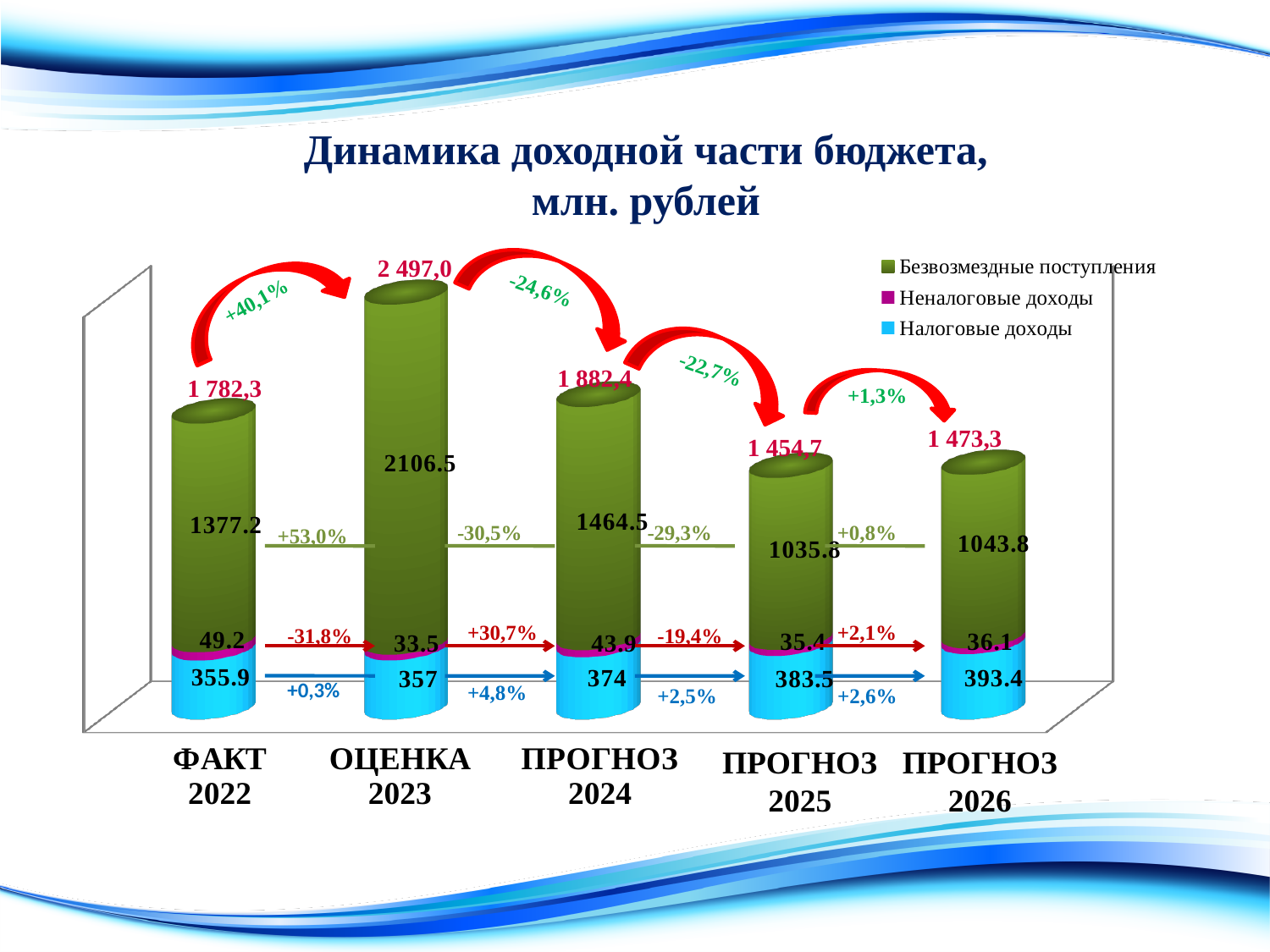
What is the value of Безвозмездные поступления for ОЦЕНКА 2023? 2106.5 What is the total of the stacked bar for ПРОГНОЗ 2025? 1 454,7 How many series does the legend list? 3 What is the value of Неналоговые доходы for ПРОГНОЗ 2024? 43.9 How many categories are shown on the x axis? 5 Do the values of Налоговые доходы rise or fall from ФАКТ 2022 to ПРОГНОЗ 2026? rise What is the total of the stacked bar for ОЦЕНКА 2023? 2 497,0 In which category is Неналоговые доходы the lowest? ОЦЕНКА 2023 What is the value of Налоговые доходы for ФАКТ 2022? 355.9 Which is larger, the total for ПРОГНОЗ 2024 or the total for ПРОГНОЗ 2025? ПРОГНОЗ 2024 In which category is Безвозмездные поступления the highest? ОЦЕНКА 2023 What is the difference between Налоговые доходы for ПРОГНОЗ 2026 and ФАКТ 2022? 37.5